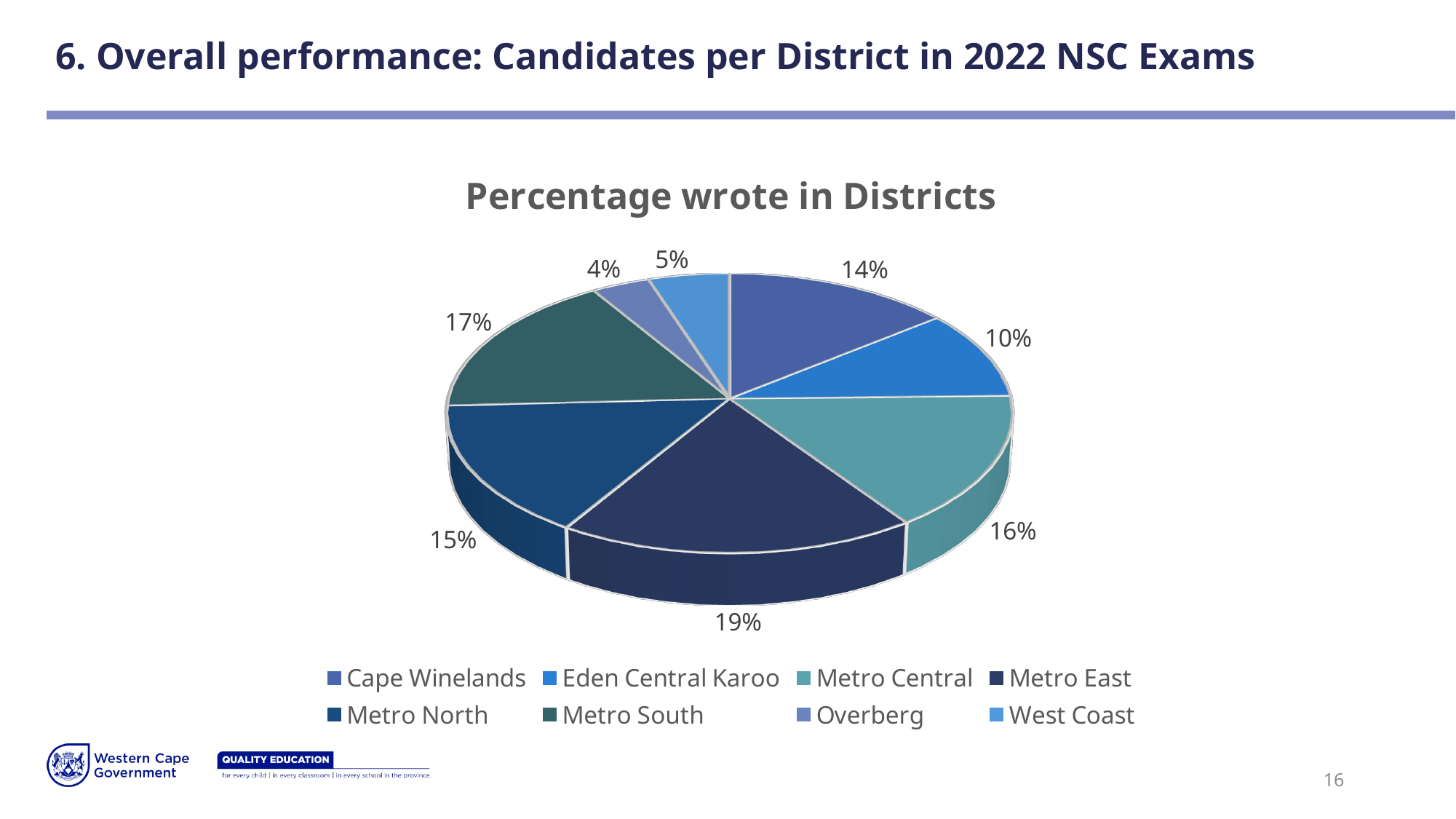
What percentage of candidates wrote in Metro South? 17% What is the combined share of Overberg and West Coast? 9% What percentage of candidates wrote in Overberg? 4% Which district has the smallest share of candidates? Overberg Which has a larger share, Metro North or Metro South? Metro South How many districts are shown in the pie chart? 8 What is the difference between the shares of Metro Central and Eden Central Karoo? 6% Which district has the largest share of candidates? Metro East What is the title of the chart? Percentage wrote in Districts What type of chart is shown on the slide? Pie chart What percentage of candidates wrote in Metro East? 19% What percentage of candidates wrote in Cape Winelands? 14%